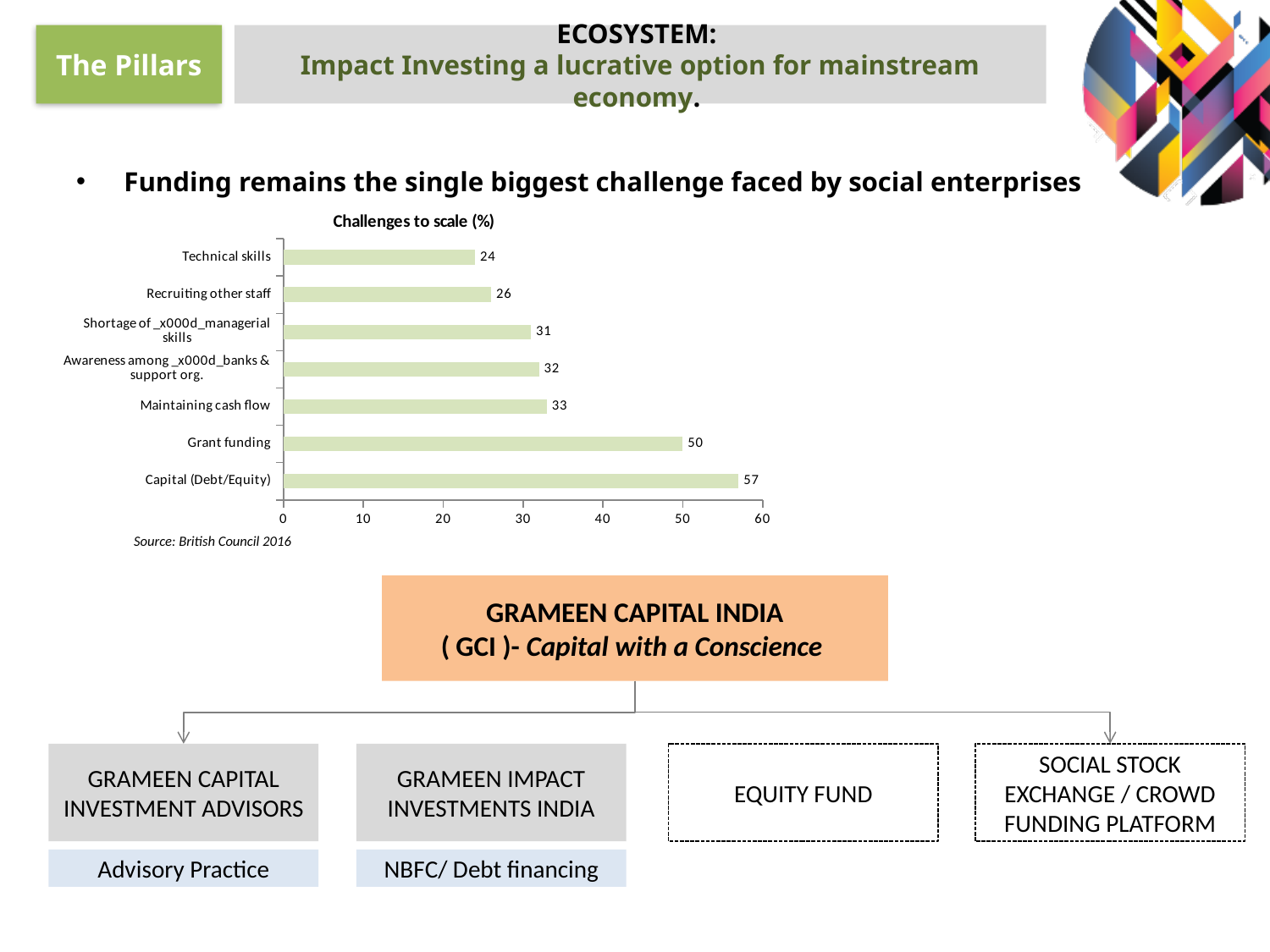
Which category has the lowest value in the Challenges to scale (%) chart? Technical skills Which is larger in the Challenges to scale (%) chart: Recruiting other staff or Maintaining cash flow? Maintaining cash flow What is the difference between the values for Capital (Debt/Equity) and Grant funding in the Challenges to scale (%) chart? 7 What is the value for Technical skills in the Challenges to scale (%) chart? 24 Which category has the highest value in the Challenges to scale (%) chart? Capital (Debt/Equity) What source is cited below the Challenges to scale (%) chart? British Council 2016 What kind of chart is the Challenges to scale (%) chart? Bar chart What is the value for Capital (Debt/Equity) in the Challenges to scale (%) chart? 57 What is the value for Maintaining cash flow in the Challenges to scale (%) chart? 33 Is the value for Grant funding in the Challenges to scale (%) chart greater or less than 40? greater What is the value for Grant funding in the Challenges to scale (%) chart? 50 How many categories are shown in the Challenges to scale (%) chart? 7